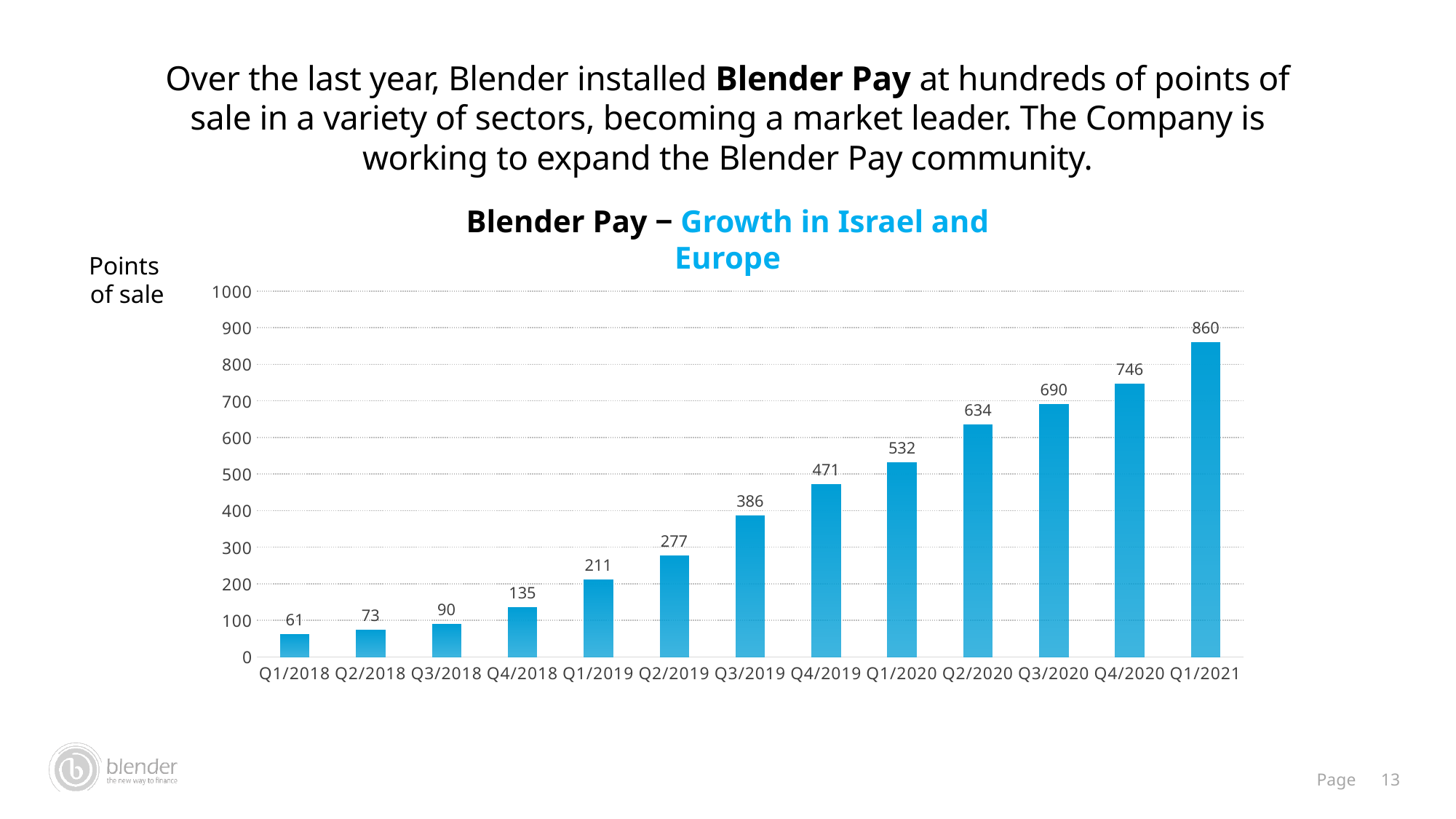
How many quarters are shown on the x axis? 13 What is the number of points of sale in Q3/2019? 386 What is the number of points of sale in Q1/2021? 860 What kind of chart is shown on the slide? Bar chart What is the difference in points of sale between Q1/2021 and Q4/2020? 114 What is the number of points of sale in Q1/2018? 61 Which is larger, the value for Q2/2020 or the value for Q1/2020? Q2/2020 What is the difference in points of sale between Q4/2019 and Q4/2018? 336 Which quarter has the lowest number of points of sale? Q1/2018 Which quarter has the highest number of points of sale? Q1/2021 Do the values rise or fall from Q1/2018 to Q1/2021? Rise Is the value for Q3/2020 greater or less than 600? greater